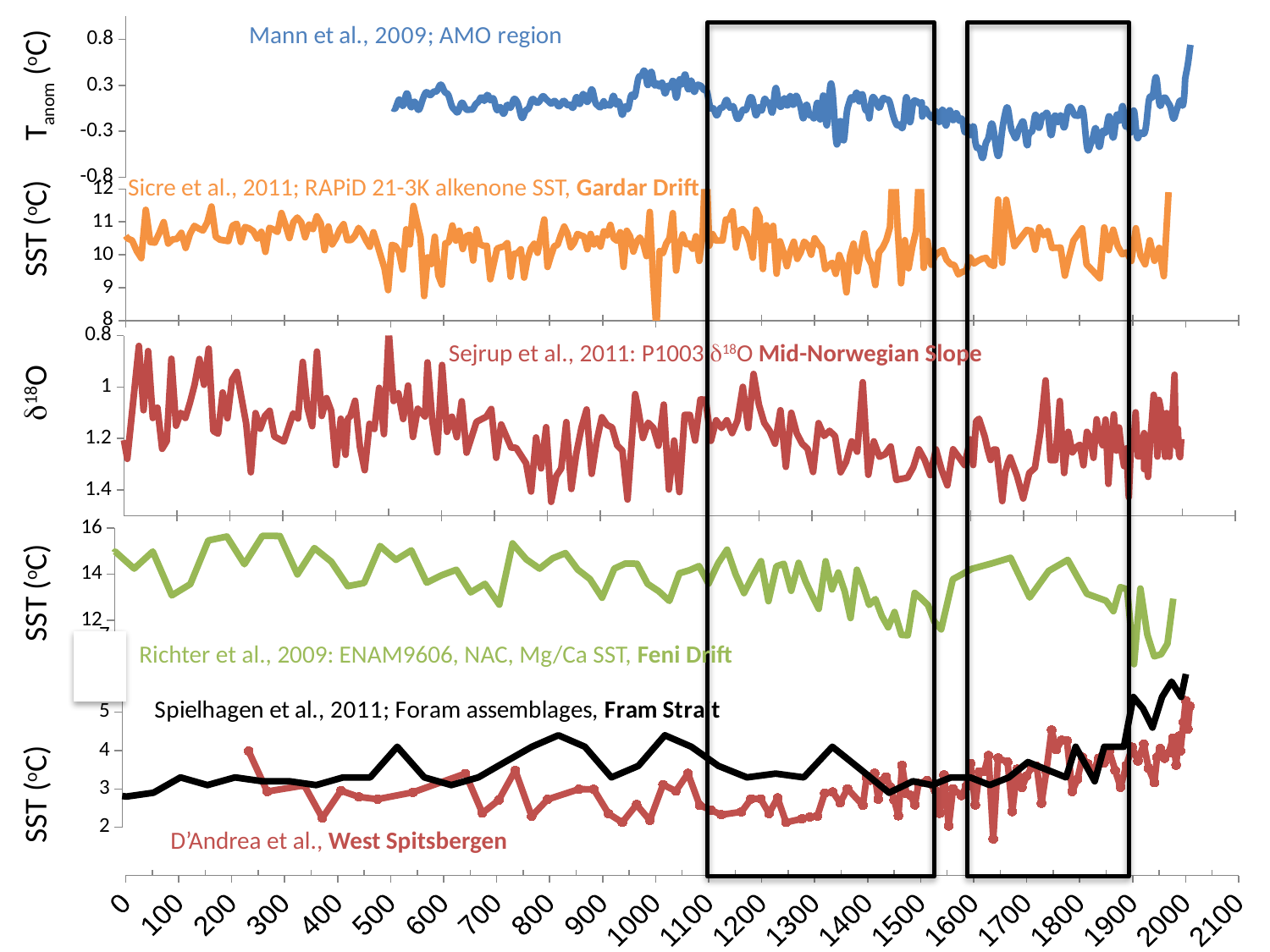
How many stacked chart panels are shown on the slide? 5 In the bottom panel, is the value of the black Fram Strait line at year 0 greater or less than 3? less In the Feni Drift SST panel (Richter et al., 2009), do the values overall rise or fall from year 0 to year 1500? fall Which site is plotted as the green line (Richter et al., 2009)? Feni Drift How many series are plotted in the bottom panel (Spielhagen et al. and D'Andrea et al.)? 2 In the bottom panel, does the black Fram Strait line rise or fall from year 1900 to year 2000? rise In the top panel (Mann et al., 2009; AMO region), is the value around year 1650 greater or less than -0.3? less Which record is plotted as the blue line in the top panel? Mann et al., 2009; AMO region In the bottom panel at around year 1000, which series has the higher SST: Fram Strait (black) or West Spitsbergen (red)? Fram Strait In the Feni Drift SST panel (Richter et al., 2009), is the value at year 0 greater or less than 14? greater What kind of chart is used in each panel of this slide? line chart